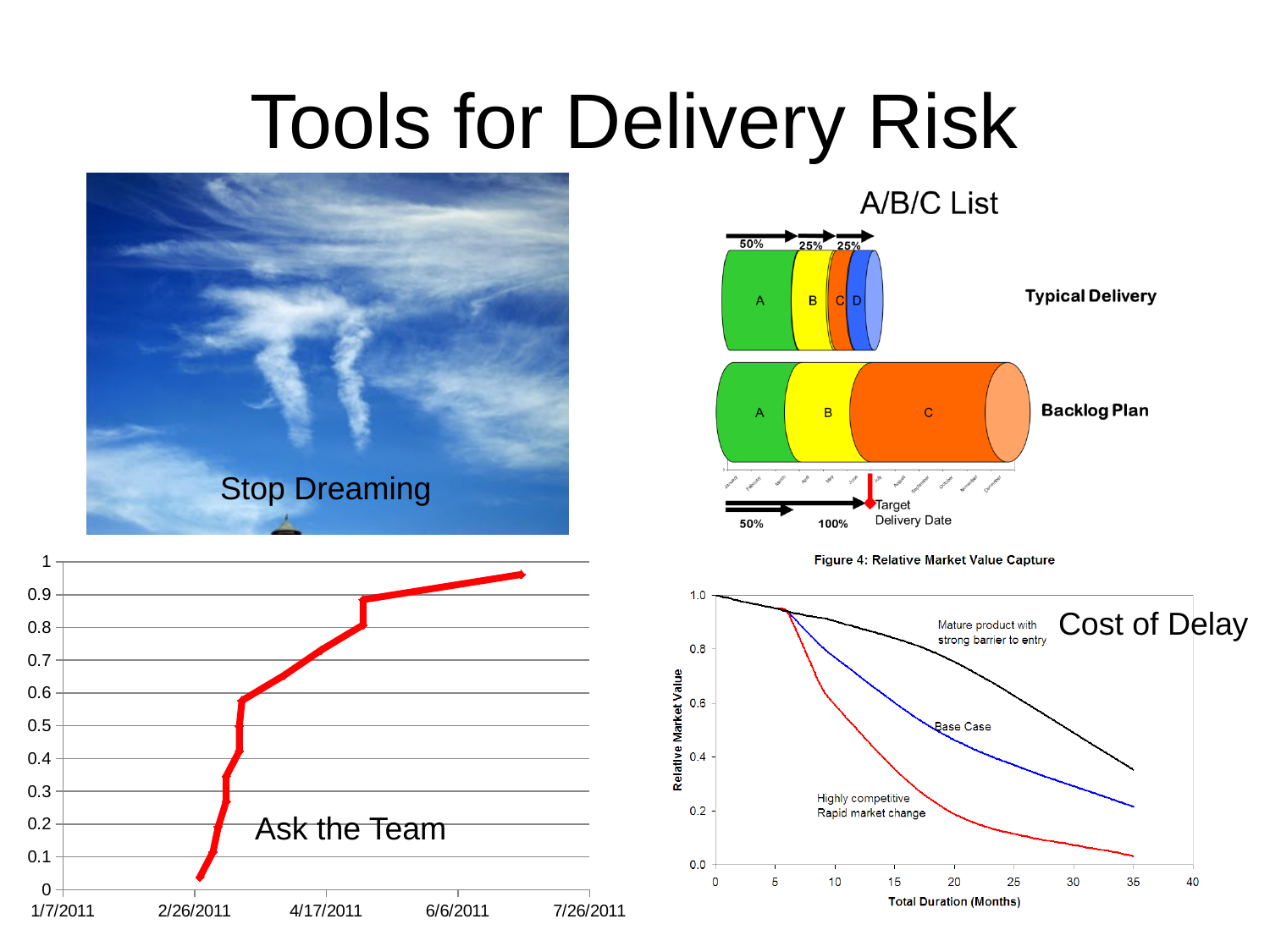
In the 'Ask the Team' chart at the bottom left, is the value of the last plotted point greater or less than 0.9? greater What kind of chart is the 'Ask the Team' chart at the bottom left of the slide? line chart In the 'Ask the Team' chart at the bottom left, is the value of the first plotted point greater or less than 0.1? less What is the title of the 'Cost of Delay' chart at the bottom right of the slide? Figure 4: Relative Market Value Capture In the 'Ask the Team' chart at the bottom left, what is the first date label shown on the x axis? 1/7/2011 In the 'Figure 4: Relative Market Value Capture' chart, which line has the highest Relative Market Value at 35 months? Mature product with strong barrier to entry In the 'Figure 4: Relative Market Value Capture' chart, do the values rise or fall as Total Duration increases? fall In the 'Figure 4: Relative Market Value Capture' chart, is the 'Mature product with strong barrier to entry' value at 20 months greater or less than 0.6? greater In the 'Figure 4: Relative Market Value Capture' chart, which line has the lowest Relative Market Value at 35 months? Highly competitive Rapid market change In the 'Ask the Team' chart at the bottom left, do the values rise or fall along the x axis? rise How many lines are plotted in the 'Figure 4: Relative Market Value Capture' chart? 3